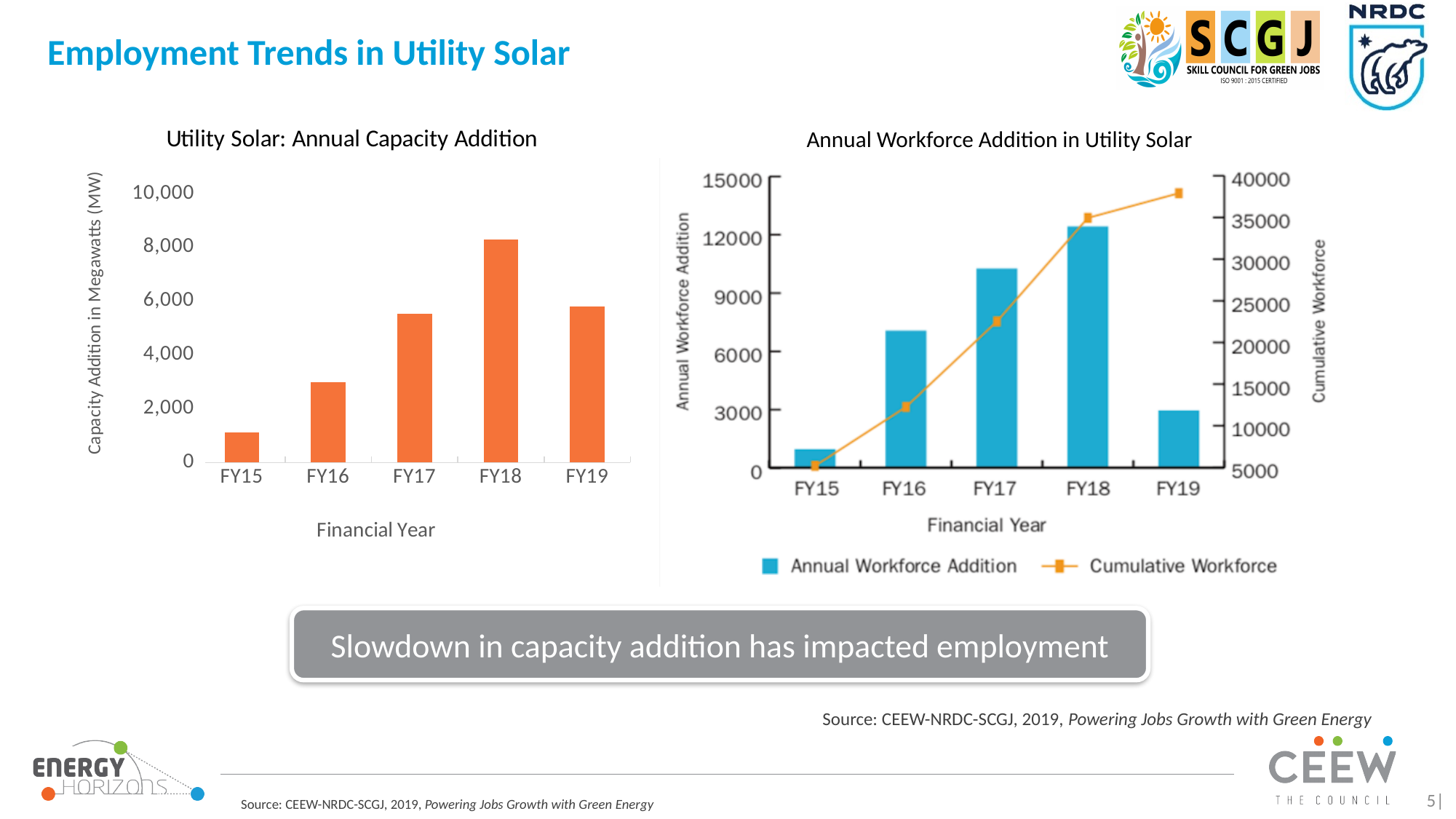
In the 'Utility Solar: Annual Capacity Addition' chart, which is larger, the value for FY17 or FY19? FY19 In the 'Annual Workforce Addition in Utility Solar' chart, does the Cumulative Workforce line rise or fall from FY15 to FY19? Rise In the 'Annual Workforce Addition in Utility Solar' chart, which financial year has the highest annual workforce addition? FY18 What kind of chart is 'Utility Solar: Annual Capacity Addition'? Bar chart In the 'Utility Solar: Annual Capacity Addition' chart, which financial year has the lowest capacity addition? FY15 In the 'Annual Workforce Addition in Utility Solar' chart, which financial year has the lowest annual workforce addition? FY15 In the 'Utility Solar: Annual Capacity Addition' chart, is the value for FY18 greater or less than 8,000? greater In the 'Annual Workforce Addition in Utility Solar' chart, is the annual workforce addition for FY19 greater or less than 6000? less How many financial years are shown in the 'Utility Solar: Annual Capacity Addition' chart? 5 How many series does the legend of the 'Annual Workforce Addition in Utility Solar' chart list? 2 In the 'Utility Solar: Annual Capacity Addition' chart, is the value for FY16 greater or less than 4,000? less In the 'Utility Solar: Annual Capacity Addition' chart, which financial year has the highest capacity addition? FY18